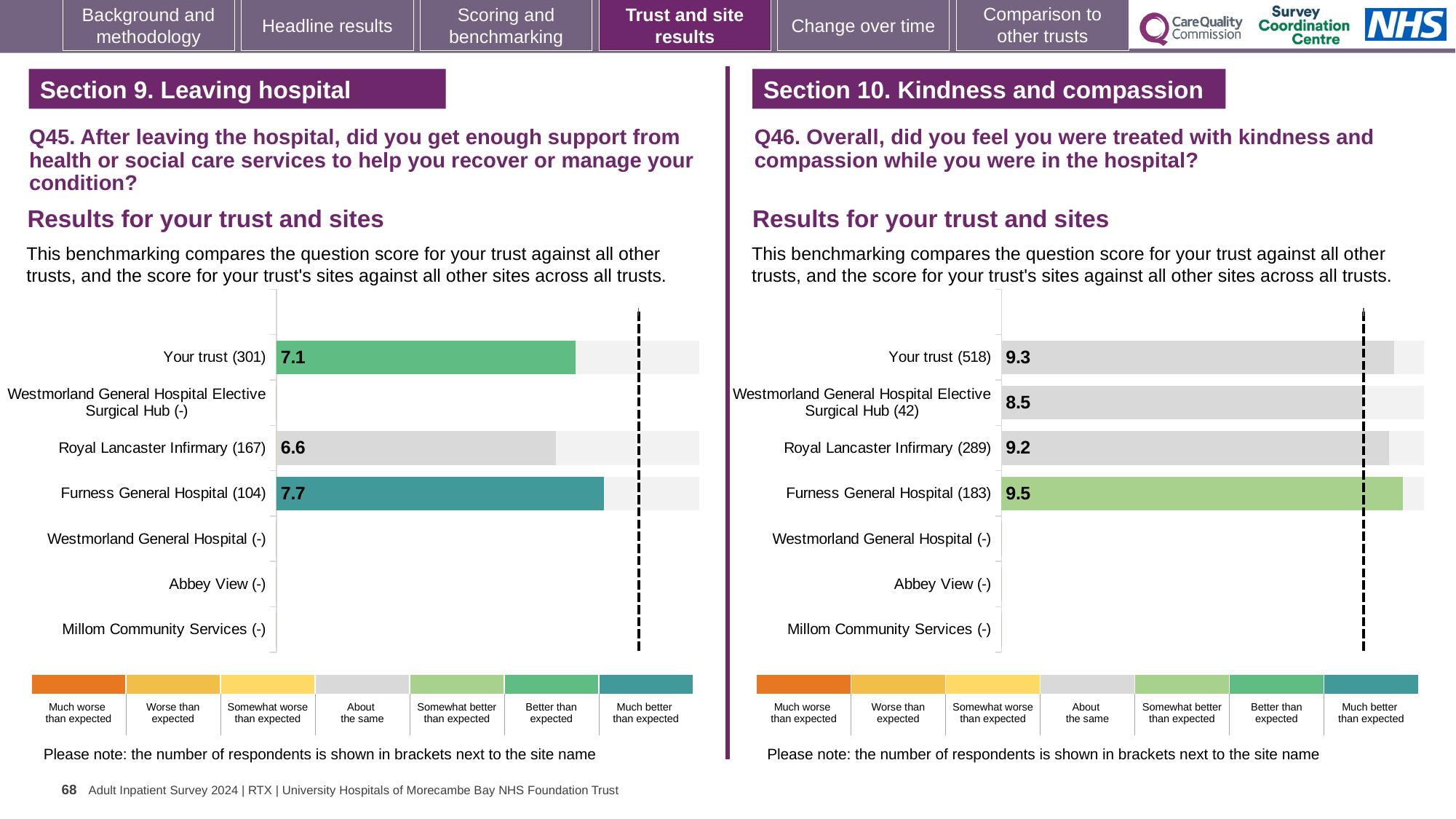
In the Q46 chart on the right, which is larger: the score for Furness General Hospital or Royal Lancaster Infirmary? Furness General Hospital In the Q46 chart on the right, which site has the lowest score? Westmorland General Hospital Elective Surgical Hub In the Q46 chart on the right, what is the difference between the scores for Furness General Hospital and Your trust? 0.2 In the Q45 chart on the left, what is the score for Your trust? 7.1 How many site/trust categories are listed on the y axis of the Q45 chart on the left? 7 In the Q46 chart on the right, what is the score for Your trust? 9.3 In the Q45 chart on the left, what is the difference between the scores for Furness General Hospital and Royal Lancaster Infirmary? 1.1 In the Q45 chart on the left, which site has the highest score? Furness General Hospital In the Q46 chart on the right, what is the score for Westmorland General Hospital Elective Surgical Hub? 8.5 What kind of chart is used for the Q46 results on the right? Bar chart In the Q45 chart on the left, what is the score for Royal Lancaster Infirmary? 6.6 In the Q45 chart on the left, how many respondents are shown for Furness General Hospital? 104